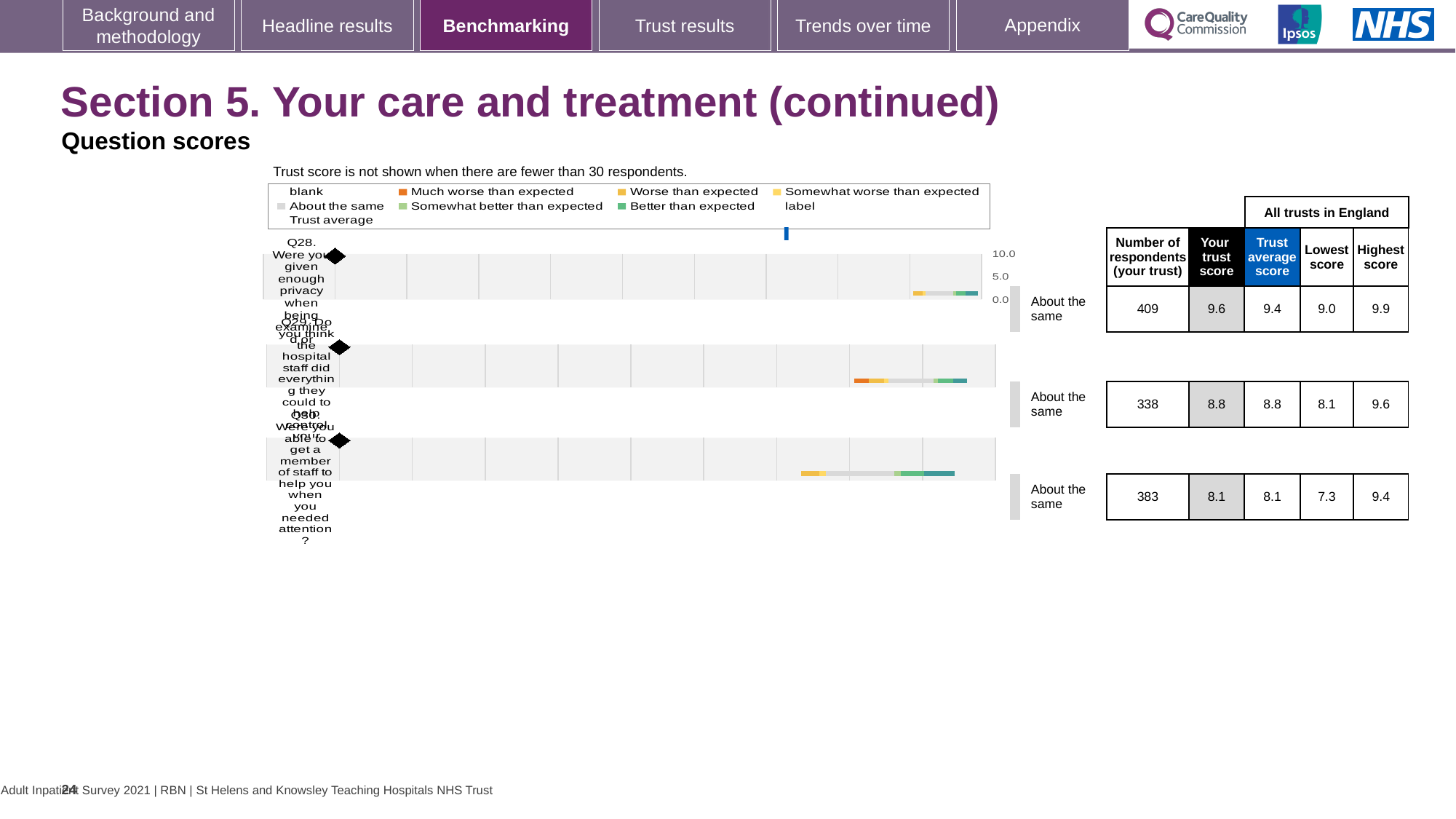
Is the trust score marker for Q28 greater or less than 5.0 on the axis? greater Which question has the highest 'Your trust score'? Q28 What is the highest score across all trusts in England for Q30? 9.4 What is the 'Your trust score' for Q28? 9.6 For Q28, which is larger: the 'Your trust score' or the 'Trust average score'? Your trust score For Q28, what is the difference between the highest score and the lowest score across all trusts in England? 0.9 In the chart legend, what does the orange colour represent? Much worse than expected Which question has the lowest 'Lowest score' across all trusts in England? Q30 How many questions are plotted on the slide? 3 What kind of chart is used to show the question scores for Q28, Q29 and Q30? bar chart What benchmark category is shown next to the Q30 chart? About the same How many respondents are shown for Q29? 338